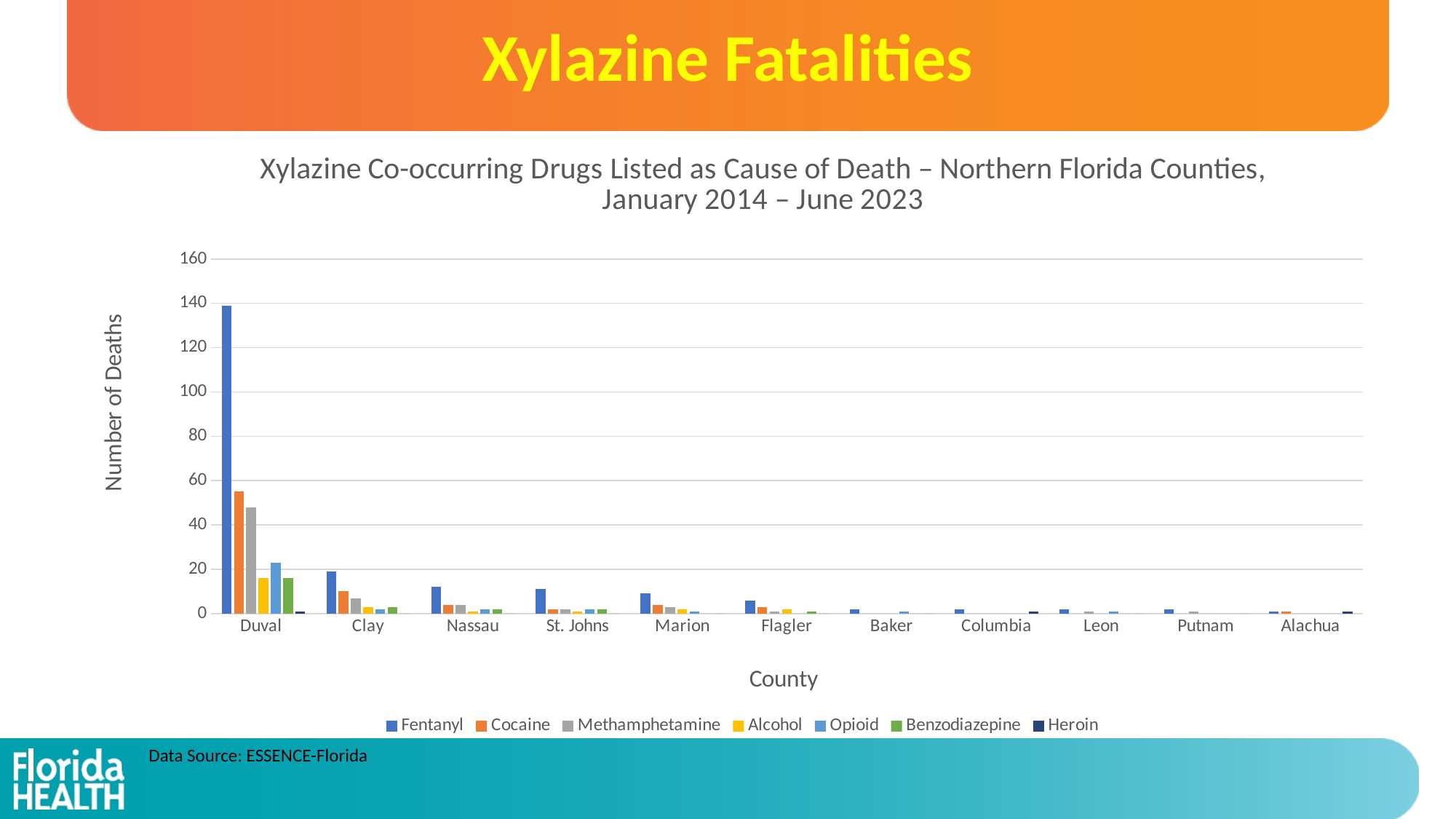
In Duval, which is larger: the Cocaine value or the Methamphetamine value? Cocaine Which county has more Fentanyl deaths, Clay or Nassau? Clay Do the Fentanyl values generally rise or fall moving from Duval to Alachua along the x axis? fall Is the Fentanyl value for Duval greater or less than 120? greater How many series does the chart legend list? 7 Which county has the highest number of Fentanyl deaths? Duval Is the Fentanyl value for Clay greater or less than 40? less Is the Fentanyl value for Nassau greater or less than 20? less What kind of chart is shown on the slide? bar chart How many counties are shown on the x axis of the chart? 11 What is the label of the y axis of the chart? Number of Deaths